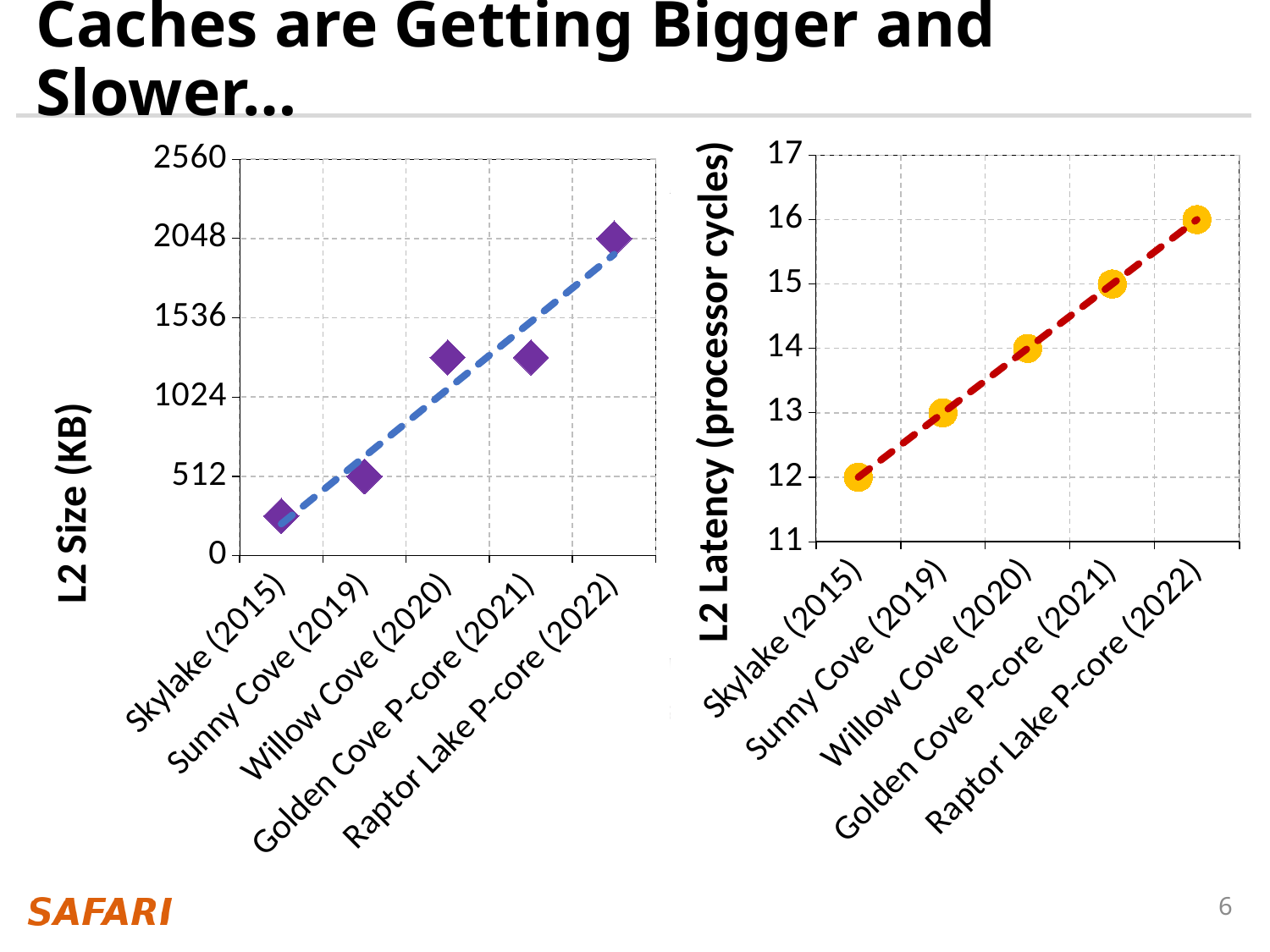
In the L2 Latency (processor cycles) chart on the right, which processor has the lowest latency? Skylake (2015) In the L2 Size (KB) chart on the left, which processor has the highest L2 size? Raptor Lake P-core (2022) In the L2 Latency (processor cycles) chart on the right, what is the value for Raptor Lake P-core (2022)? 16 In the L2 Size (KB) chart on the left, is the value for Skylake (2015) greater or less than 512? less In the L2 Latency (processor cycles) chart on the right, what is the difference between Raptor Lake P-core (2022) and Skylake (2015)? 4 In the L2 Size (KB) chart on the left, what is the value for Sunny Cove (2019)? 512 In the L2 Latency (processor cycles) chart on the right, what is the value for Willow Cove (2020)? 14 How many processors are plotted in the L2 Latency (processor cycles) chart on the right? 5 In the L2 Latency (processor cycles) chart on the right, do the values rise or fall from Skylake (2015) to Raptor Lake P-core (2022)? rise In the L2 Size (KB) chart on the left, is the value for Willow Cove (2020) greater or less than 1024? greater In the L2 Latency (processor cycles) chart on the right, what is the value for Skylake (2015)? 12 In the L2 Size (KB) chart on the left, what is the value for Raptor Lake P-core (2022)? 2048